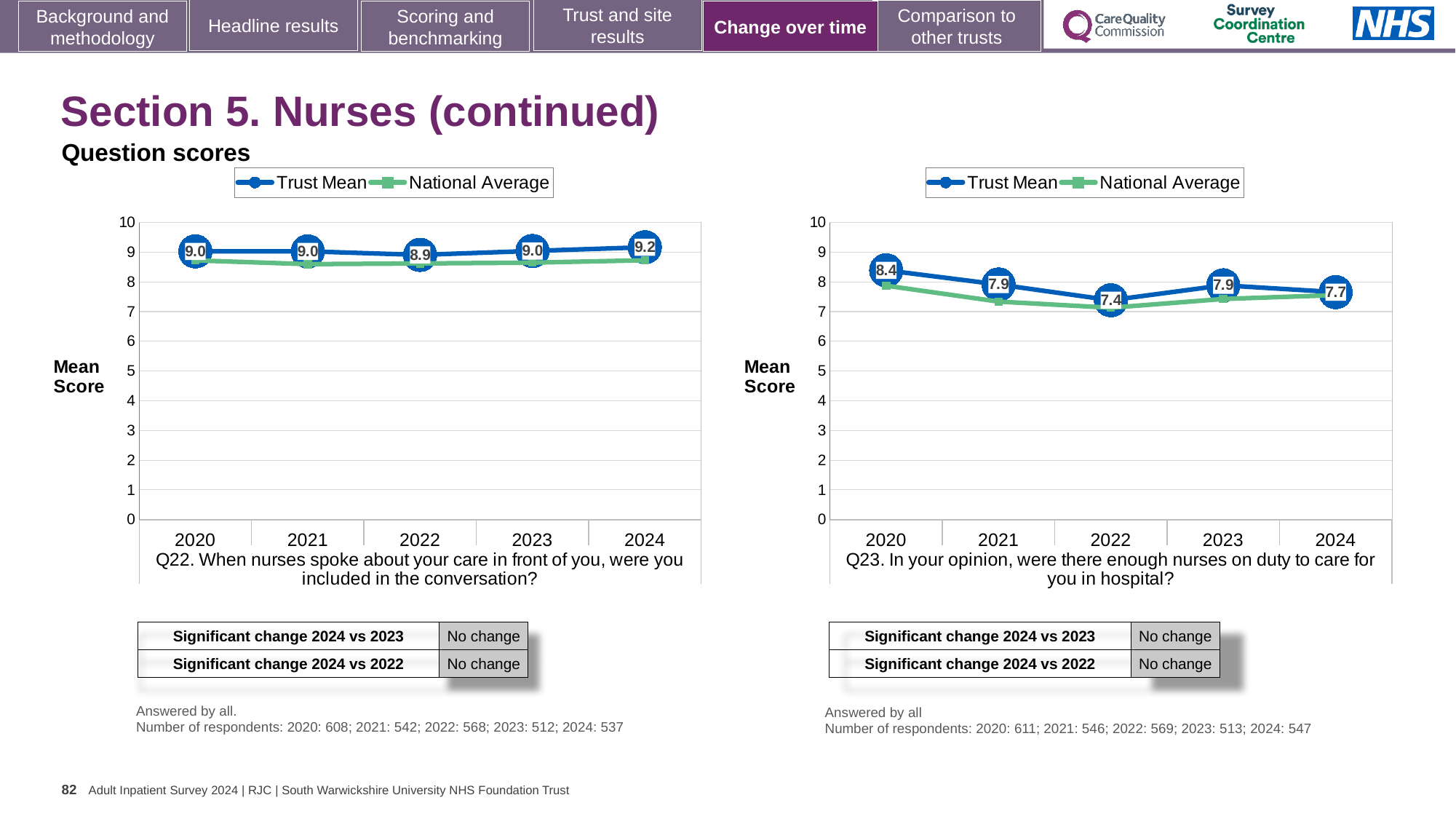
In the Q23 chart on the right, does the Trust Mean rise or fall from 2020 to 2022? Fall In the Q22 chart on the left, which year has the lowest Trust Mean score? 2022 What type of chart is used for Q23 on the right? Line chart In the Q22 chart on the left, is the National Average value for 2020 greater or less than 8? greater In the Q23 chart on the right, is the National Average value for 2022 greater or less than 8? less How many years are shown on the x axis of the Q23 chart on the right? 5 In the Q22 chart on the left, what is the Trust Mean score for 2024? 9.2 In the Q22 chart on the left, is the Trust Mean score higher in 2024 or in 2022? 2024 How many series does the legend of the Q22 chart on the left list? 2 In the Q23 chart on the right, what is the difference between the Trust Mean scores for 2020 and 2022? 1.0 In the Q23 chart on the right, which year has the highest Trust Mean score? 2020 In the Q23 chart on the right, what is the Trust Mean score for 2022? 7.4